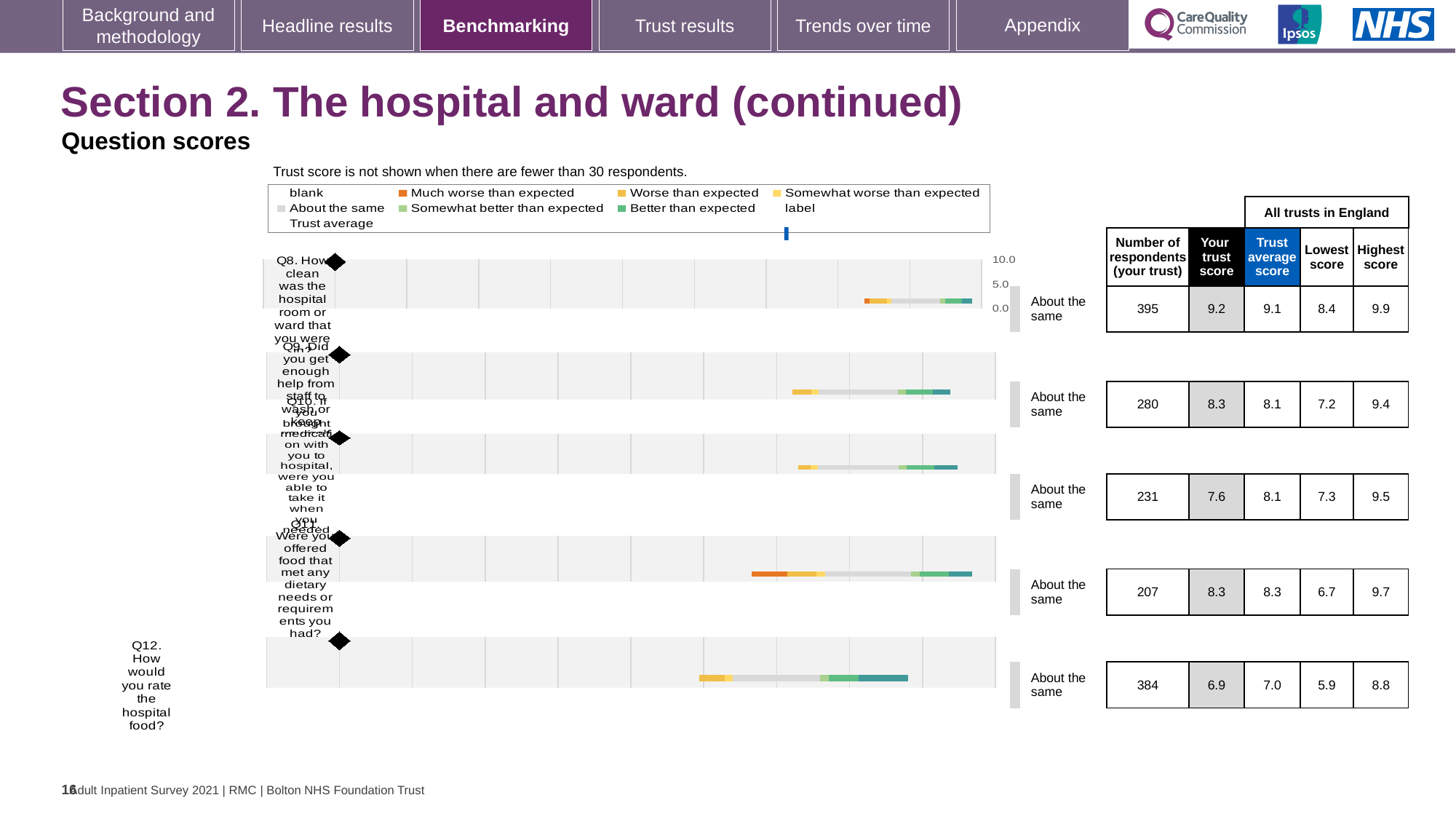
For Q10, what is the difference between the trust average score and 'Your trust score'? 0.5 How many respondents does the table show for Q8 (How clean was the hospital room or ward)? 395 Which question has the highest 'Your trust score' on this slide? Q8 What kind of chart is used to show the question scores? Bar chart What is the lowest score across all trusts in England for Q11 (food that met dietary needs)? 6.7 Which question has the lowest 'Your trust score' on this slide? Q12 What is the highest score across all trusts in England for Q9 (enough help from staff to wash or keep clean)? 9.4 What is the 'Your trust score' for Q12 (How would you rate the hospital food)? 6.9 Which question has the largest number of respondents? Q8 What is the trust average score for Q10 (medication brought with you to hospital)? 8.1 How many questions are plotted in the chart on this slide? 5 For Q9, which is larger: 'Your trust score' or the trust average score? Your trust score